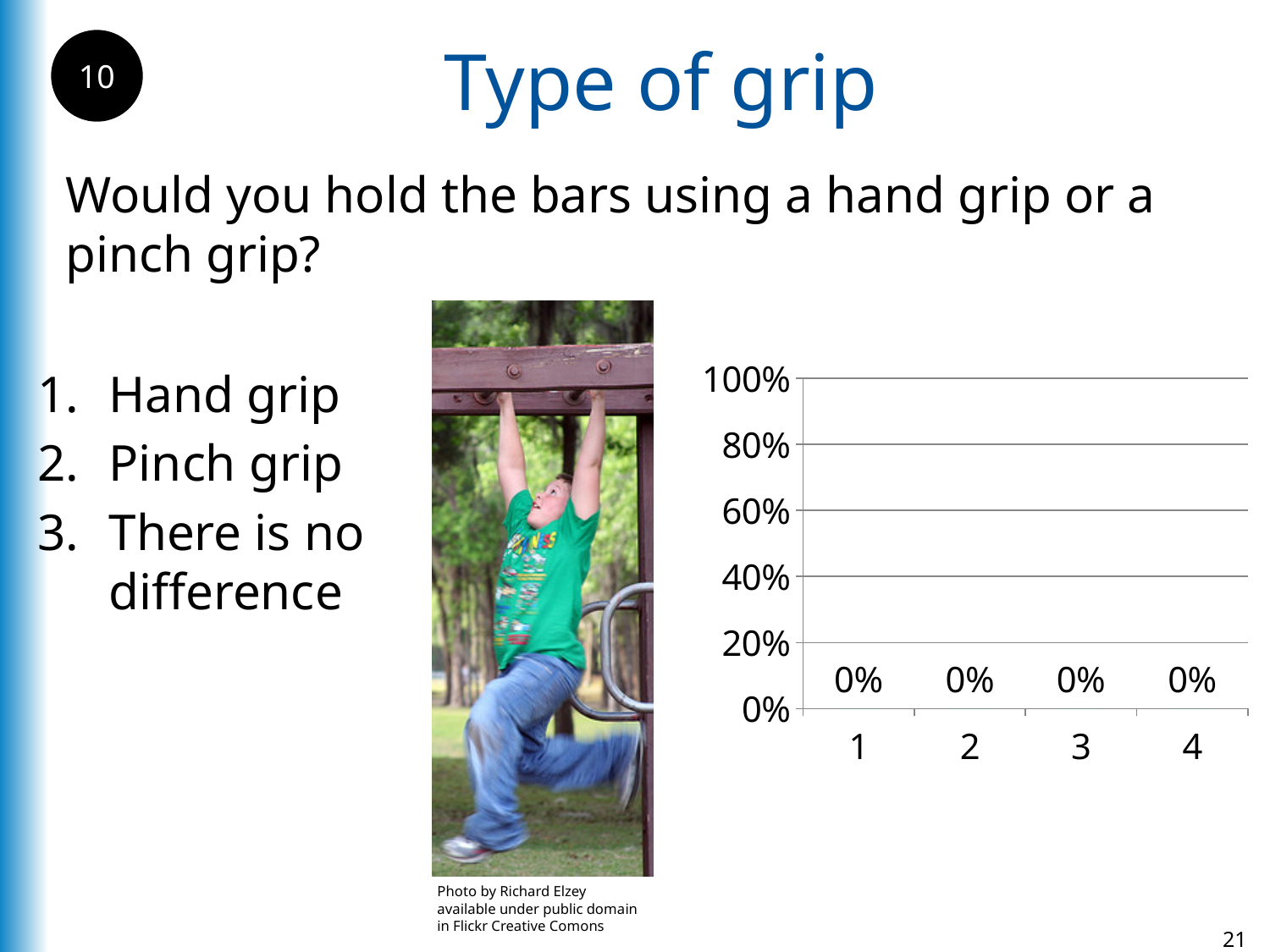
How many categories are plotted on the x axis of the chart? 4 What is the value shown for category 4 in the chart? 0% What kind of chart is shown on the slide? bar chart What is the value shown for category 1 in the chart? 0% What is the highest value marked on the chart's y axis? 100% Do the values rise, fall, or stay the same across categories 1 to 4? stay the same What is the value shown for category 3 in the chart? 0% Is the value for category 2 greater or less than 20%? less What is the difference between the values for category 2 and category 4? 0% What is the interval between the tick marks on the chart's y axis? 20%